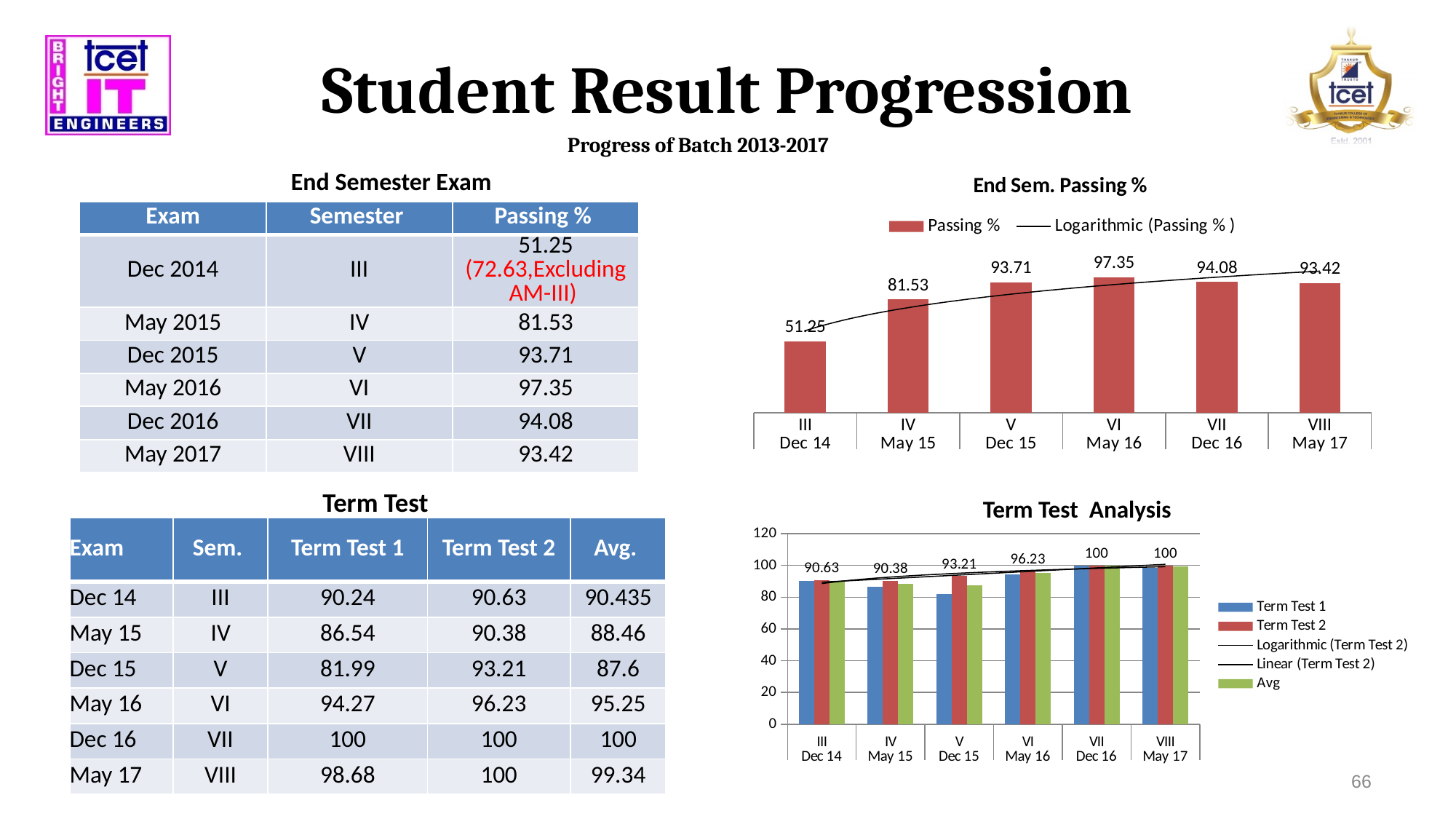
In the End Sem. Passing % chart, what is the difference between the passing % for semester IV (May 15) and semester III (Dec 14)? 30.28 In the Term Test Analysis chart, is the Term Test 1 value for semester V (Dec 15) greater or less than 100? less In the End Sem. Passing % chart, which semester has the highest passing %? VI (May 16) In the End Sem. Passing % chart, what is the passing % for semester III (Dec 14)? 51.25 In the End Sem. Passing % chart, what type of chart is used for the Passing % series? Bar chart In the Term Test Analysis chart, what is the Term Test 2 value for semester V (Dec 15)? 93.21 In the Term Test Analysis chart, how many entries does the legend list? 5 In the End Sem. Passing % chart, what is the passing % for semester VII (Dec 16)? 94.08 In the End Sem. Passing % chart, how many semesters are plotted? 6 In the End Sem. Passing % chart, which semester has the lowest passing %? III (Dec 14) In the Term Test Analysis chart, which is larger for semester IV (May 15): Term Test 1 or Term Test 2? Term Test 2 In the Term Test Analysis chart, what is the difference between the Term Test 2 values for semester VI (May 16) and semester V (Dec 15)? 3.02